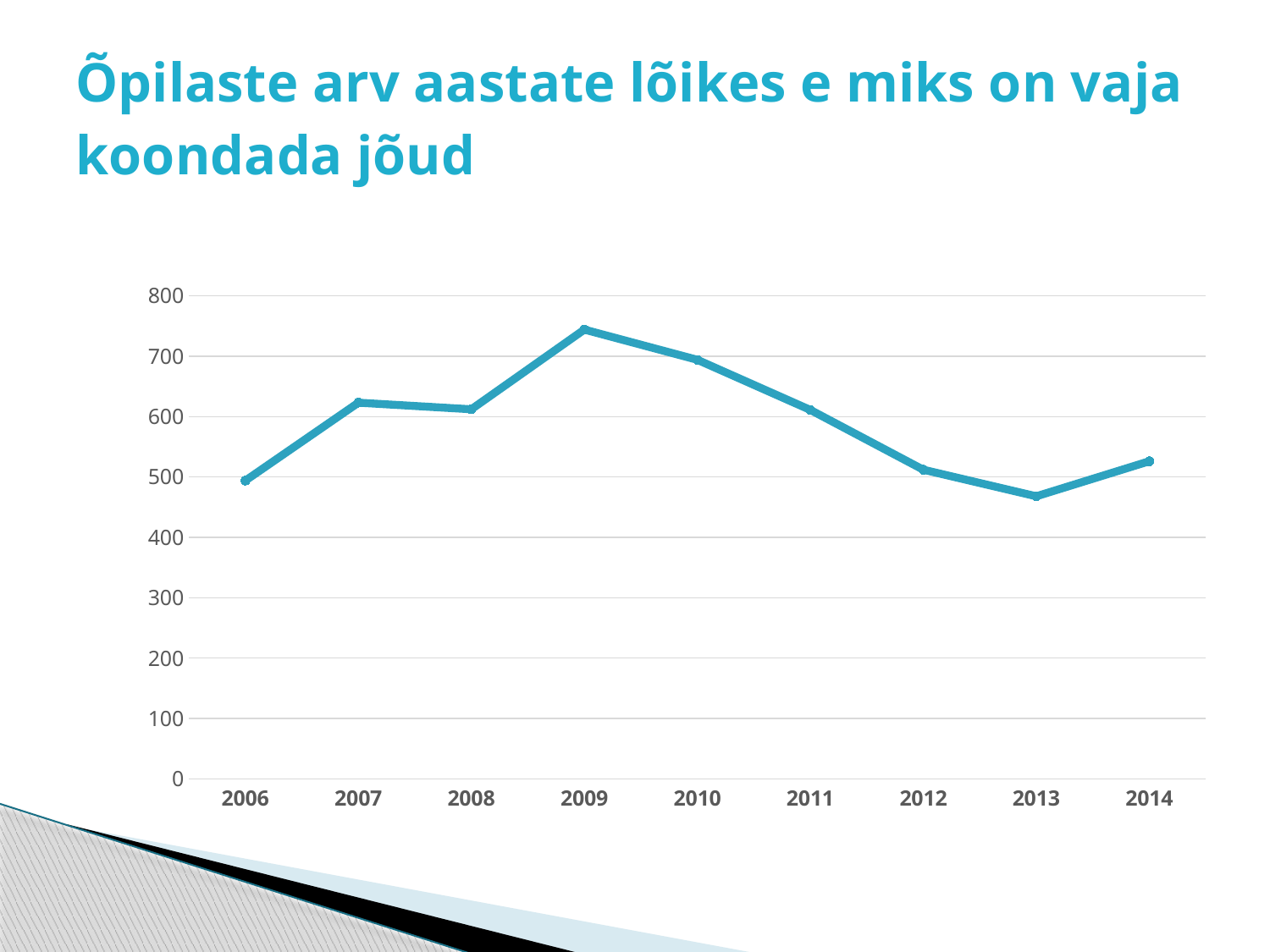
Is the value for 2007 greater or less than 600? greater Which year has the larger value, 2007 or 2012? 2007 Is the value for 2009 greater or less than 700? greater Is the value for 2012 greater or less than 600? less In which year is the number of students highest? 2009 Which year has the larger value, 2009 or 2010? 2009 In which year is the number of students lowest? 2013 Do the values rise or fall from 2009 to 2013? fall How many years are plotted on the x axis? 9 What kind of chart is shown on the slide? line chart What is the title of the slide containing the chart? Õpilaste arv aastate lõikes e miks on vaja koondada jõud